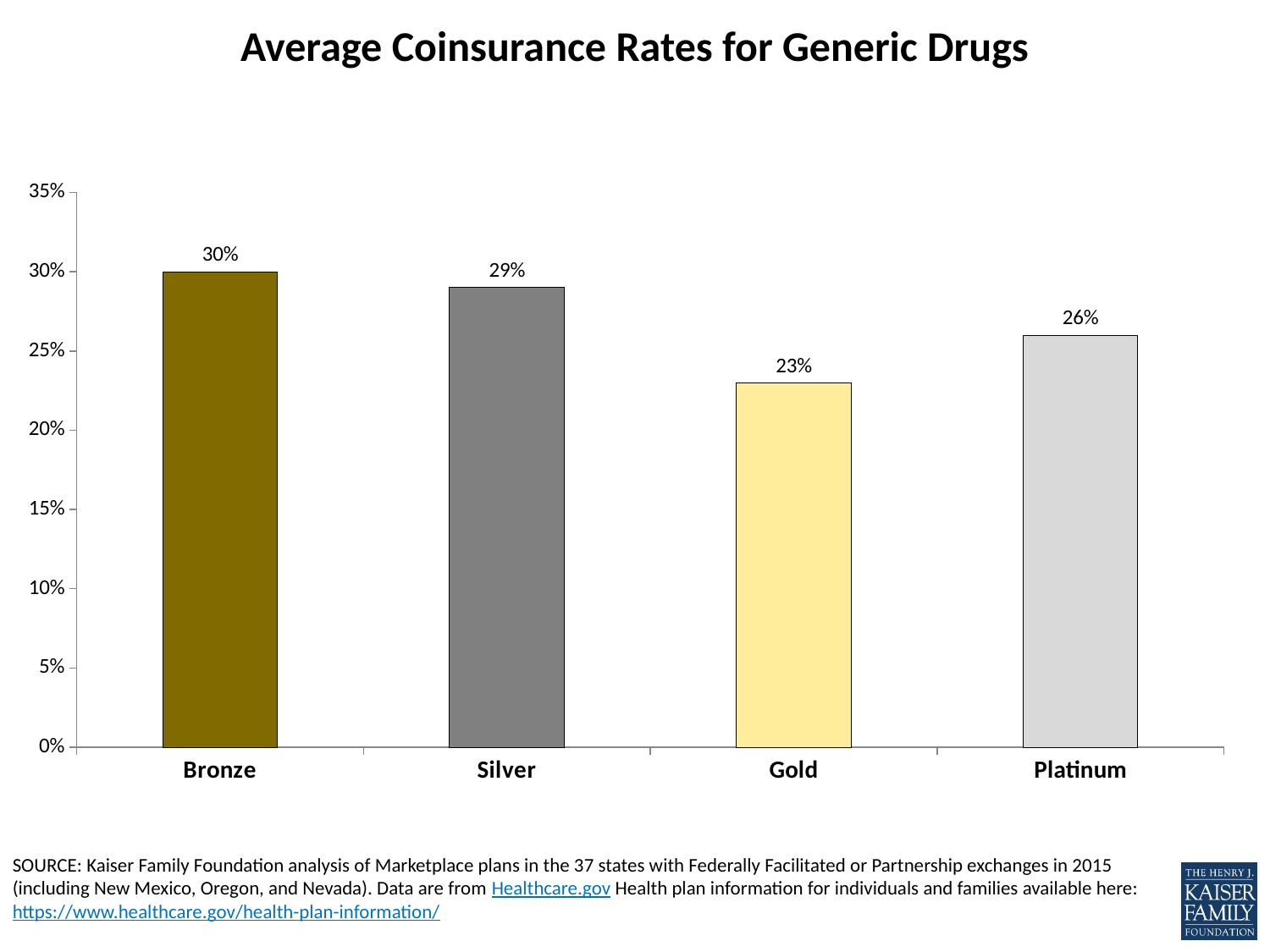
What is the difference between the Bronze and Gold average coinsurance rates? 7% What is the average coinsurance rate for generic drugs for Platinum plans? 26% What is the difference between the Platinum and Gold average coinsurance rates? 3% Is the value for Gold greater or less than 25%? less Which plan tier has the highest average coinsurance rate for generic drugs? Bronze What is the average coinsurance rate for generic drugs for Silver plans? 29% Which has a higher average coinsurance rate, Silver or Platinum? Silver What kind of chart is shown on the slide? Bar chart How many plan tiers are shown on the chart? 4 Which plan tier has the lowest average coinsurance rate for generic drugs? Gold What is the average coinsurance rate for generic drugs for Gold plans? 23% What is the average coinsurance rate for generic drugs for Bronze plans? 30%